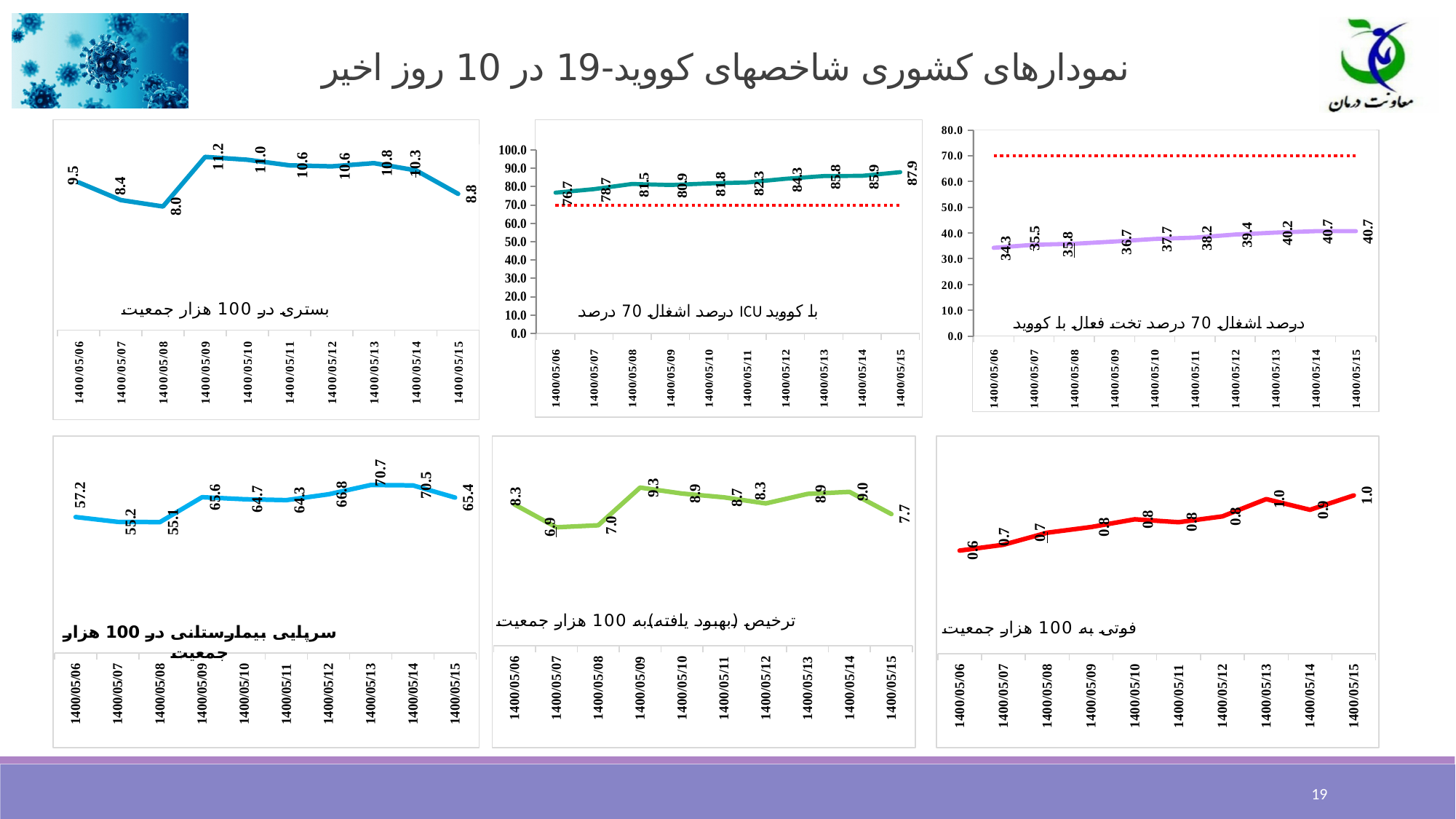
In the top-left chart (hospitalizations per 100 thousand population), which date has the lowest value? 1400/05/08 In the top-left chart (hospitalizations per 100 thousand population), what is the value for 1400/05/09? 11.2 In the top-middle chart (ICU occupancy percent with COVID), what is the value for 1400/05/15? 87.9 In the top-middle chart (ICU occupancy percent with COVID), what is the difference between the values for 1400/05/15 and 1400/05/06? 11.2 In the top-right chart (active bed occupancy percent with COVID), what is the value for 1400/05/06? 34.3 In the bottom-left chart (outpatient hospital visits per 100 thousand population), what is the value for 1400/05/15? 65.4 In the bottom-right chart (deaths per 100 thousand population), what is the value for 1400/05/06? 0.6 In the top-middle chart (ICU occupancy percent with COVID), do the values generally rise or fall from 1400/05/06 to 1400/05/15? rise In the top-right chart (active bed occupancy percent with COVID), is the value for 1400/05/15 greater or less than 70.0? less In the bottom-middle chart (discharged/recovered per 100 thousand population), which is larger, the value for 1400/05/09 or the value for 1400/05/07? 1400/05/09 How many dates are plotted on the x axis of the bottom-right chart (deaths per 100 thousand population)? 10 In the bottom-left chart (outpatient hospital visits per 100 thousand population), which date has the highest value? 1400/05/13